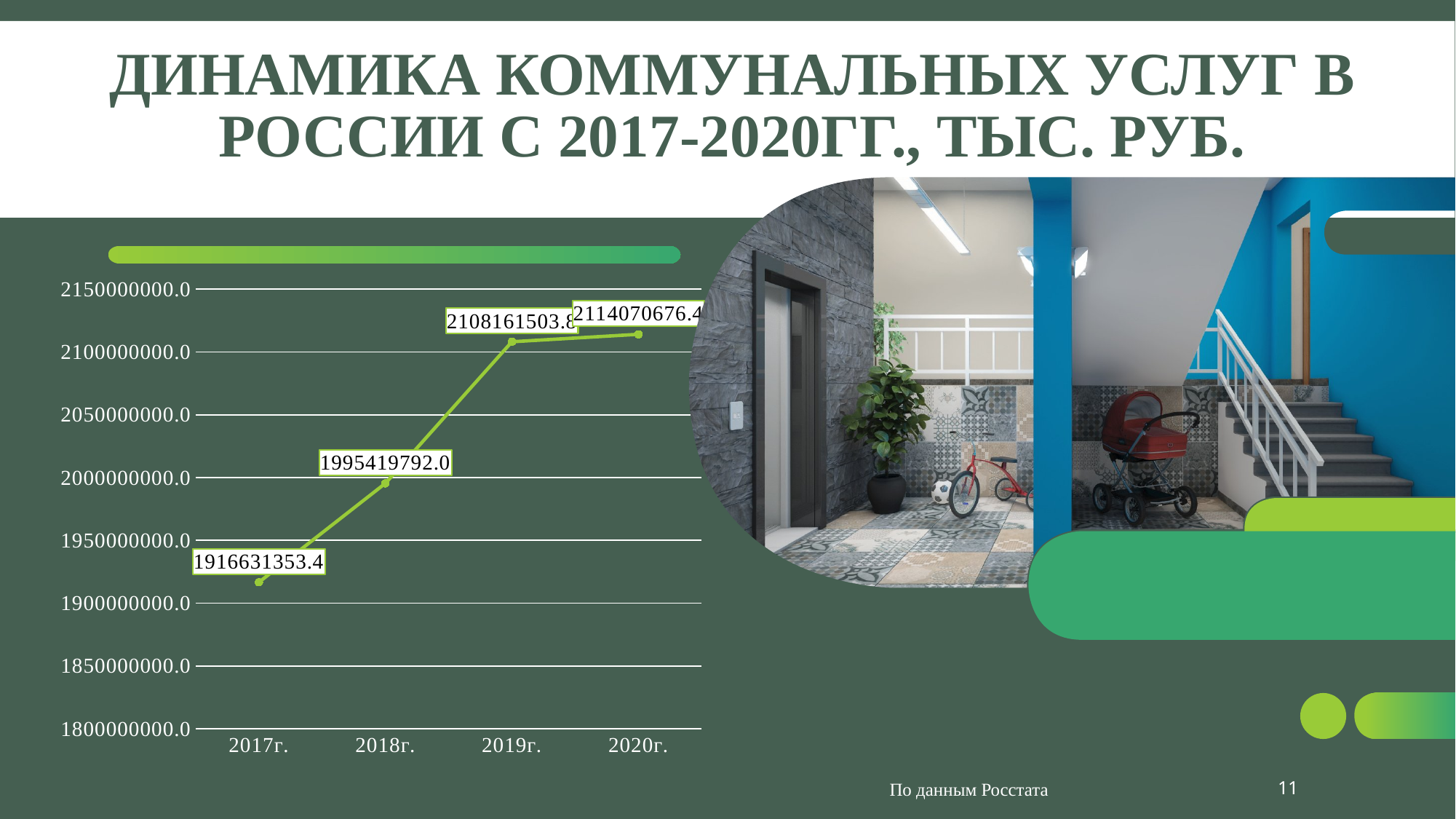
Which year has the highest value? 2020г. Is the value for 2017г. greater or less than 1950000000.0? less What is the difference between the values for 2018г. and 2017г.? 78788438.6 How many years are plotted on the chart? 4 What is the value for 2019г.? 2108161503.8 What kind of chart is shown on the slide? line chart What is the value for 2020г.? 2114070676.4 What is the difference between the values for 2019г. and 2018г.? 112741711.8 Which is larger, the value for 2019г. or the value for 2018г.? 2019г. What is the value for 2018г.? 1995419792.0 Which year has the lowest value? 2017г. What is the value for 2017г.? 1916631353.4